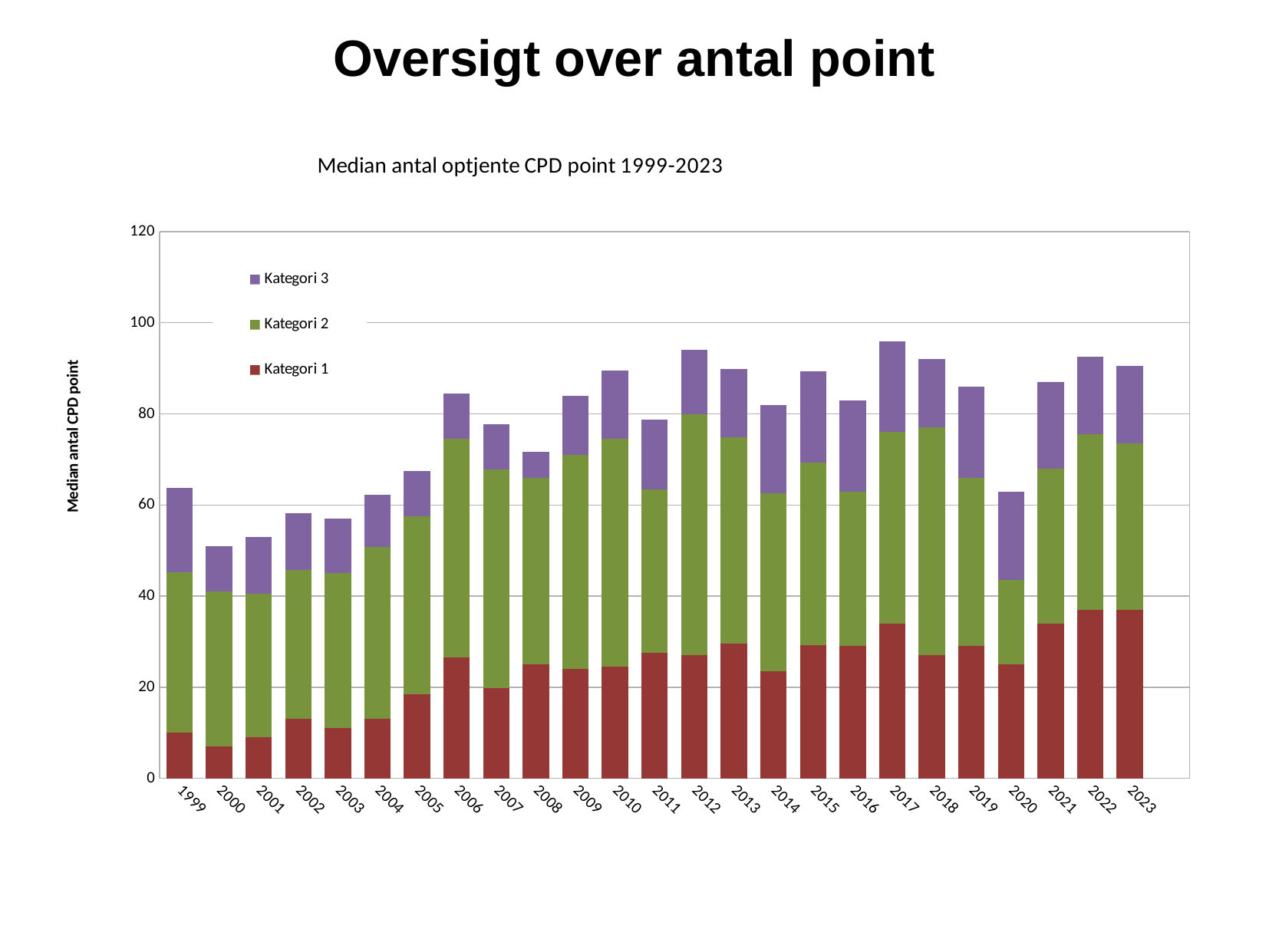
Is the total value for 2020 greater or less than 80? less Which year has the larger total, 2020 or 2021? 2021 Which year has the larger total, 2006 or 2007? 2006 Do the total values generally rise or fall from 1999 to 2012? rise What kind of chart is shown on the slide? Stacked bar chart How many series does the legend list? 3 What is the title of the chart? Median antal optjente CPD point 1999-2023 What is the label on the vertical axis? Median antal CPD point Is the total value for 2000 greater or less than 60? less How many years are shown along the x axis? 25 Is the total value for 2012 greater or less than 80? greater Which year has the tallest stacked bar? 2017